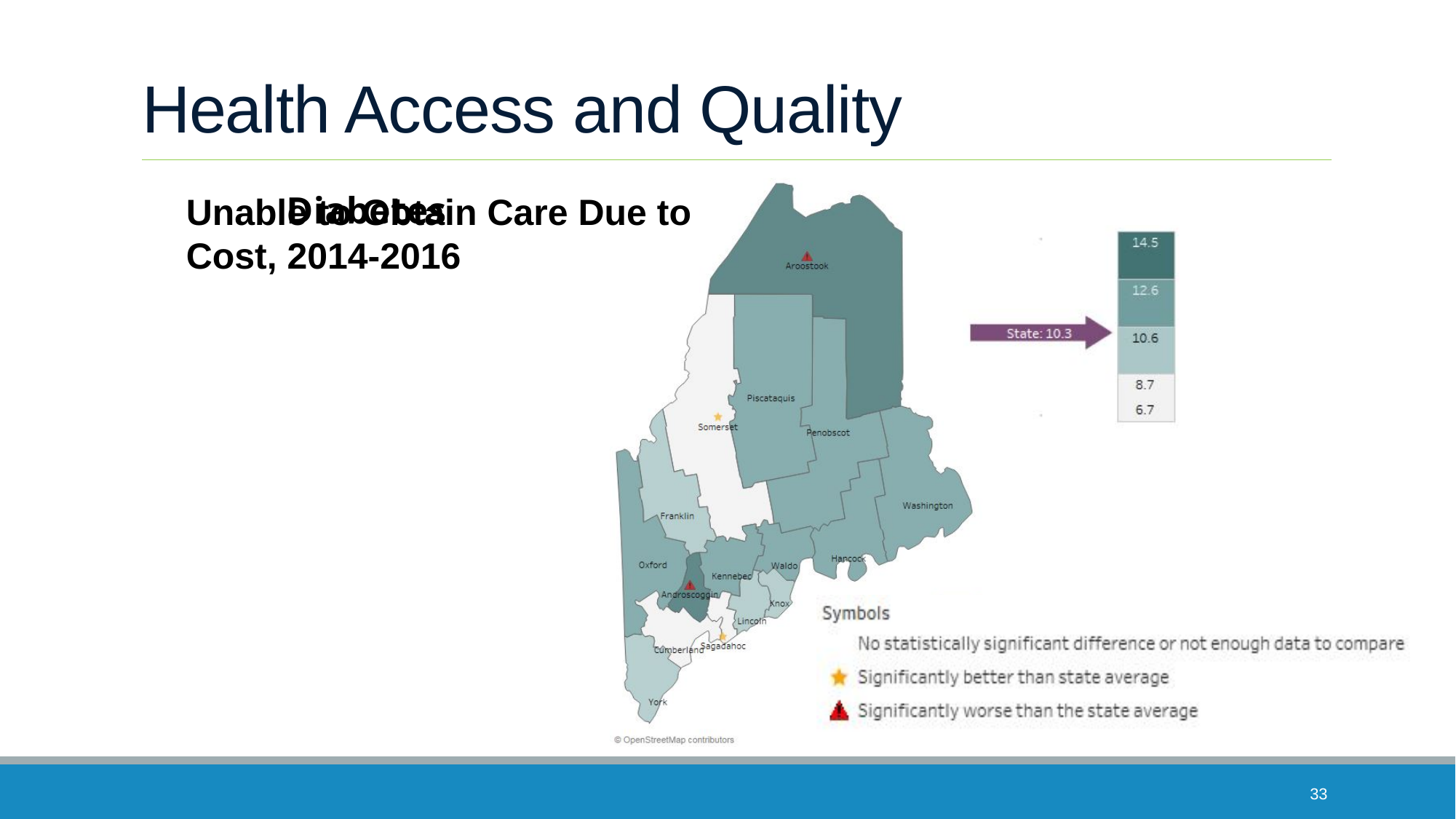
What kind of chart is shown on the slide? Map (choropleth map of Maine counties) Which counties are marked with a red triangle as significantly worse than the state average? Aroostook and Androscoggin Which counties are marked with a star as significantly better than the state average? Somerset and Sagadahoc Which county has a higher value, Aroostook or Somerset? Aroostook How many value levels are shown on the colour legend? 5 What is the state value shown by the arrow next to the legend? State: 10.3 What is the lowest value shown on the colour legend? 6.7 Is the value for Aroostook greater or less than 10.6? greater How many counties are labelled on the map? 16 What is the highest value shown on the colour legend? 14.5 What is the difference between the highest and lowest values on the colour legend? 7.8